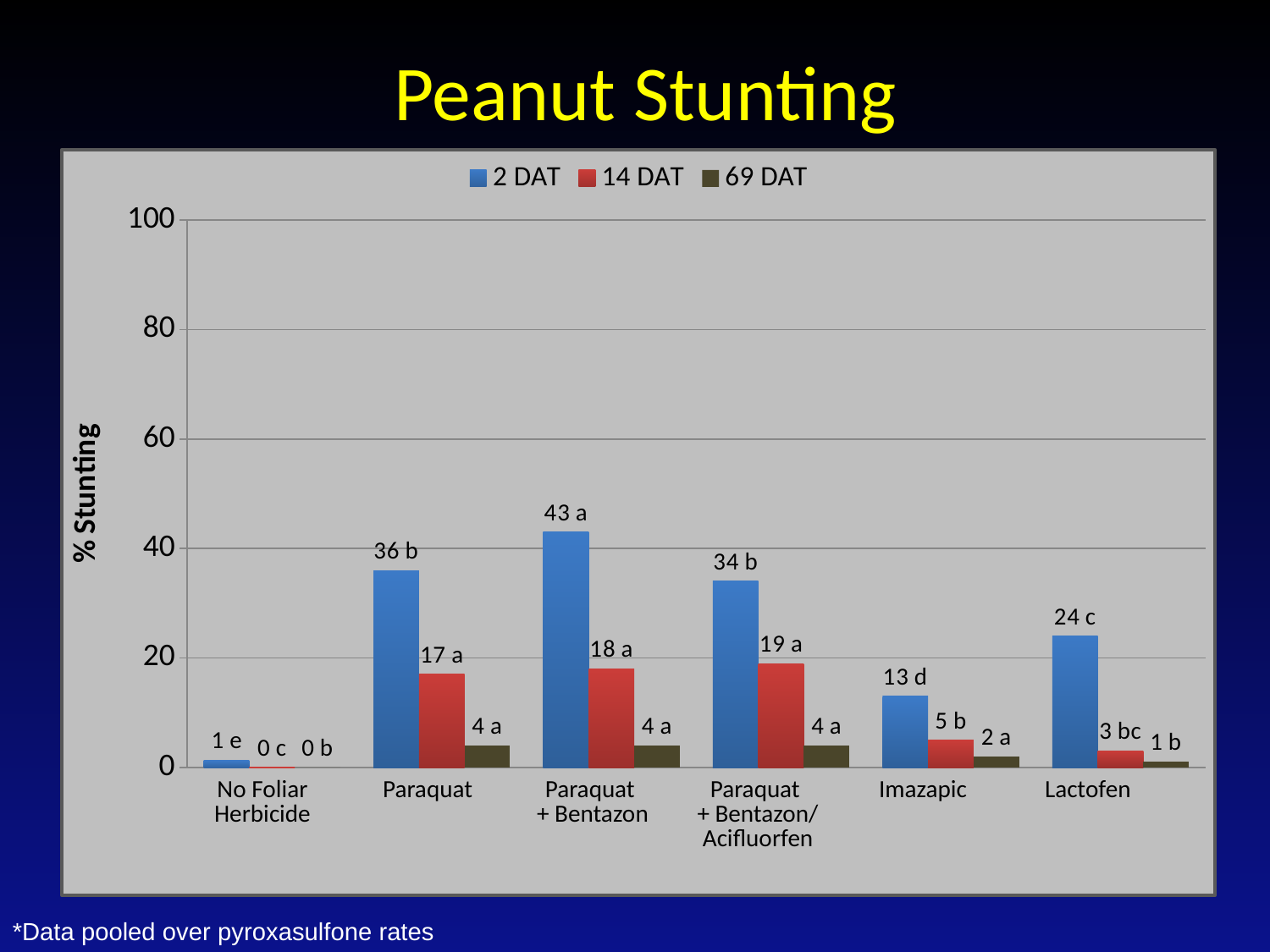
What is the 69 DAT value labelled for Lactofen in the Peanut Stunting chart? 1 b Which treatment has the lowest 2 DAT % stunting in the Peanut Stunting chart? No Foliar Herbicide What is the 2 DAT value labelled for Paraquat + Bentazon in the Peanut Stunting chart? 43 a Which is larger in the Peanut Stunting chart: the 2 DAT value for Lactofen or the 2 DAT value for Imazapic? Lactofen How many herbicide treatment categories are shown on the x axis of the Peanut Stunting chart? 6 What is the y-axis label of the Peanut Stunting chart? % Stunting Is the 2 DAT value for Paraquat + Bentazon/Acifluorfen greater or less than 40 in the Peanut Stunting chart? less What is the difference between the 2 DAT values for Paraquat + Bentazon and Paraquat in the Peanut Stunting chart? 7 What type of chart is shown on the Peanut Stunting slide? bar chart How many series does the legend list in the Peanut Stunting chart? 3 What is the 14 DAT value labelled for Imazapic in the Peanut Stunting chart? 5 b Which treatment has the highest 2 DAT % stunting in the Peanut Stunting chart? Paraquat + Bentazon